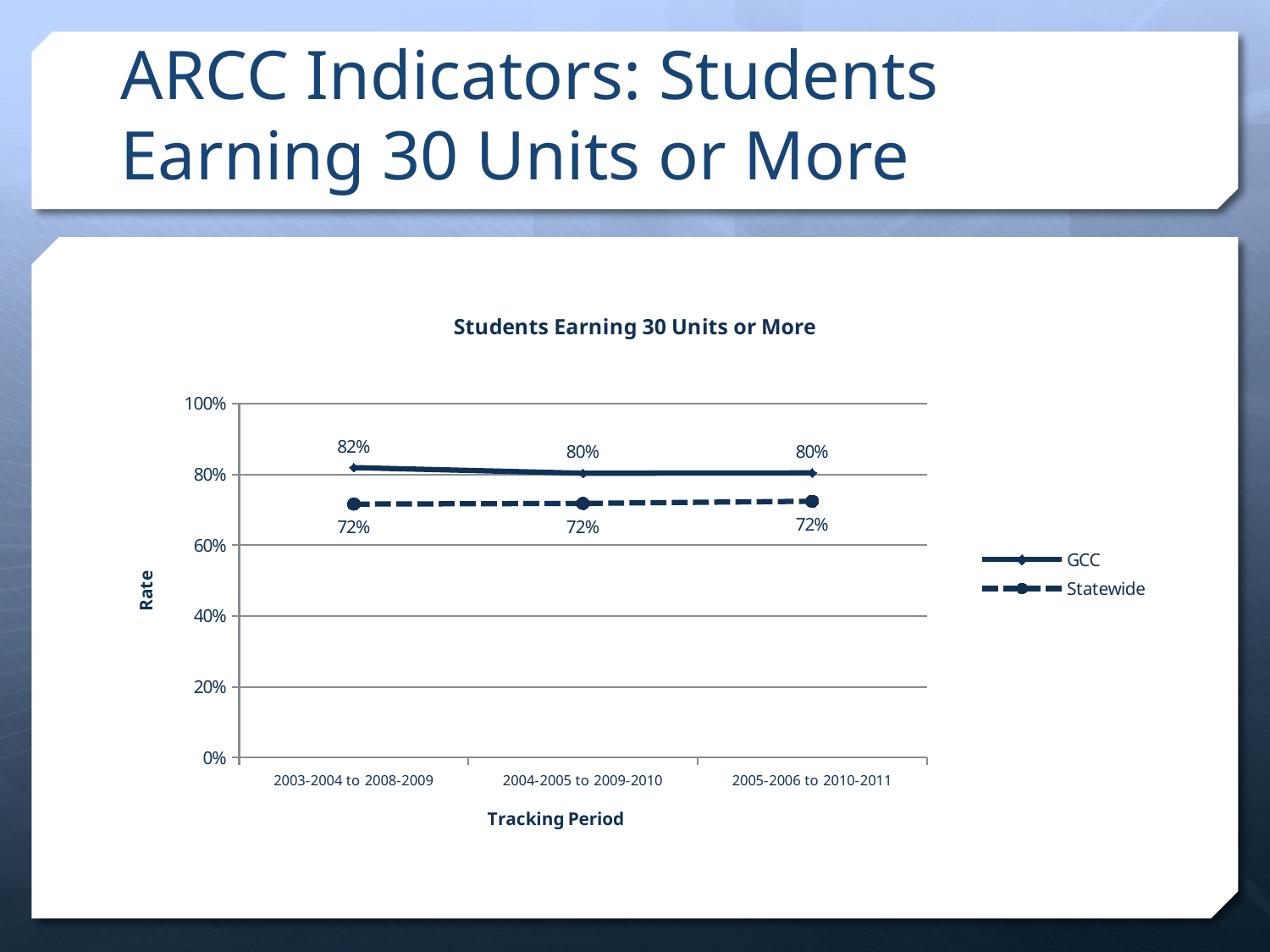
What kind of chart is shown on the slide? line chart What is the Statewide rate for the 2005-2006 to 2010-2011 tracking period? 72% How many series does the legend list? 2 Which tracking period has the highest GCC rate? 2003-2004 to 2008-2009 What is the difference between the GCC and Statewide rates in the 2005-2006 to 2010-2011 tracking period? 8% What is the GCC rate for the 2004-2005 to 2009-2010 tracking period? 80% What is the GCC rate for the 2003-2004 to 2008-2009 tracking period? 82% What is the title of the chart? Students Earning 30 Units or More Is the Statewide rate for 2004-2005 to 2009-2010 greater or less than 80%? less Which series has the higher rate in the 2004-2005 to 2009-2010 tracking period, GCC or Statewide? GCC What is the difference between the GCC and Statewide rates in the 2003-2004 to 2008-2009 tracking period? 10% How many tracking periods are shown on the x axis? 3